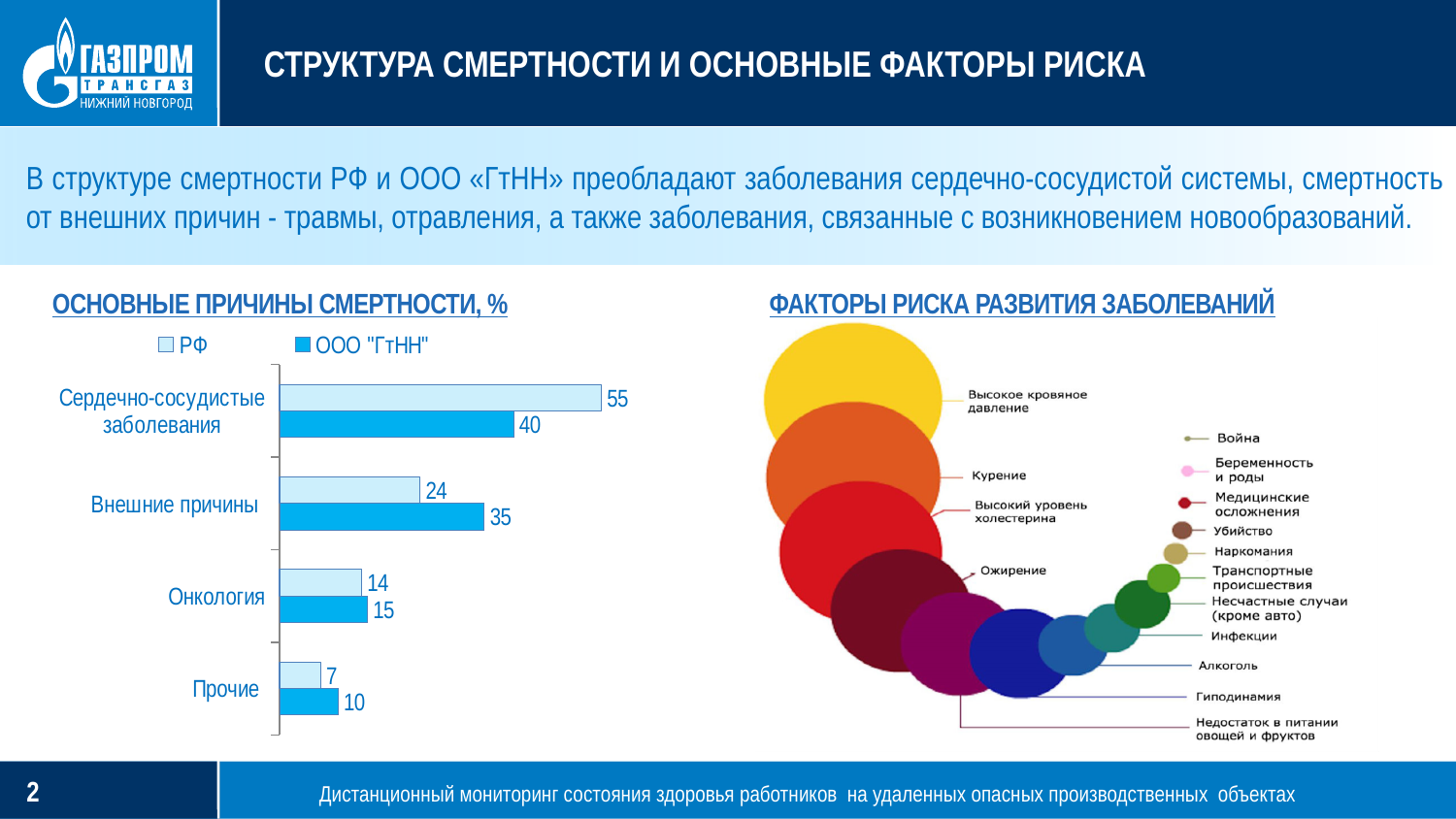
In the chart "ОСНОВНЫЕ ПРИЧИНЫ СМЕРТНОСТИ, %", which category has the highest value for РФ? Сердечно-сосудистые заболевания In the chart "ОСНОВНЫЕ ПРИЧИНЫ СМЕРТНОСТИ, %", which category has the lowest value for ООО "ГтНН"? Прочие In the chart "ОСНОВНЫЕ ПРИЧИНЫ СМЕРТНОСТИ, %", which series is shown in the darker blue colour? ООО "ГтНН" How many categories are shown in the chart "ОСНОВНЫЕ ПРИЧИНЫ СМЕРТНОСТИ, %"? 4 In the chart "ОСНОВНЫЕ ПРИЧИНЫ СМЕРТНОСТИ, %", what is the value for ООО "ГтНН" for Прочие? 10 In the chart "ОСНОВНЫЕ ПРИЧИНЫ СМЕРТНОСТИ, %", what is the difference between the РФ and ООО "ГтНН" values for Сердечно-сосудистые заболевания? 15 In the chart "ОСНОВНЫЕ ПРИЧИНЫ СМЕРТНОСТИ, %", what is the value for ООО "ГтНН" for Внешние причины? 35 What kind of chart is "ОСНОВНЫЕ ПРИЧИНЫ СМЕРТНОСТИ, %"? Bar chart In the chart "ОСНОВНЫЕ ПРИЧИНЫ СМЕРТНОСТИ, %", which is larger for Онкология: the РФ value or the ООО "ГтНН" value? ООО "ГтНН" In the chart "ОСНОВНЫЕ ПРИЧИНЫ СМЕРТНОСТИ, %", what is the difference between the ООО "ГтНН" and РФ values for Внешние причины? 11 In the chart "ОСНОВНЫЕ ПРИЧИНЫ СМЕРТНОСТИ, %", what is the value for РФ for Сердечно-сосудистые заболевания? 55 How many series does the legend of the chart "ОСНОВНЫЕ ПРИЧИНЫ СМЕРТНОСТИ, %" list? 2